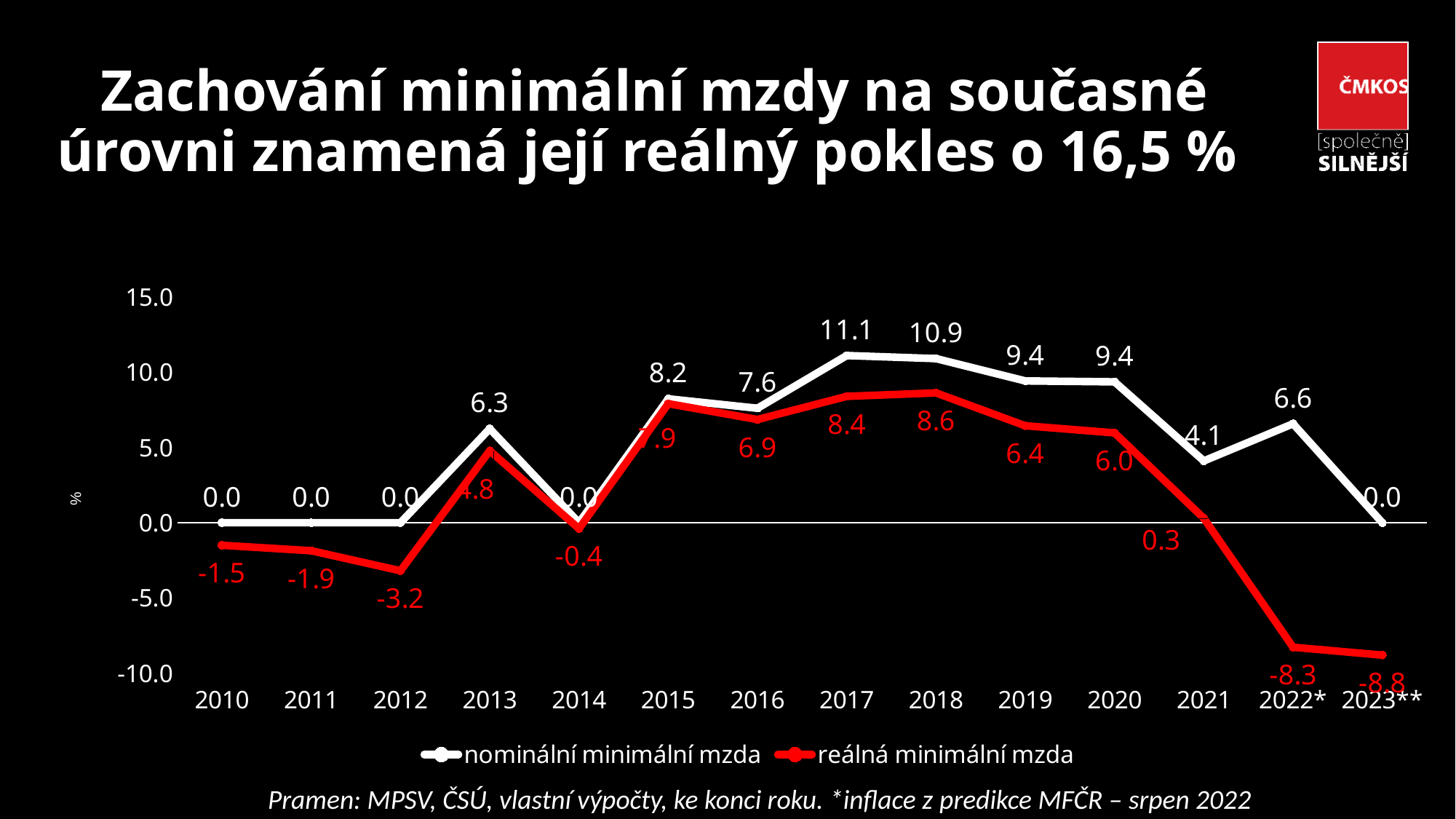
What is the value of reálná minimální mzda in 2012? -3.2 How many years are plotted on the x axis? 14 In which year is reálná minimální mzda lowest? 2023** What is the difference between nominální minimální mzda and reálná minimální mzda in 2022*? 14.9 In which year is nominální minimální mzda highest? 2017 What is the value of nominální minimální mzda in 2017? 11.1 How many series does the legend list? 2 What is the value of reálná minimální mzda in 2023**? -8.8 What colour is the line for reálná minimální mzda? red Which is larger in 2013: nominální minimální mzda or reálná minimální mzda? nominální minimální mzda What type of chart is shown on the slide? line chart Does reálná minimální mzda rise or fall from 2020 to 2023**? fall